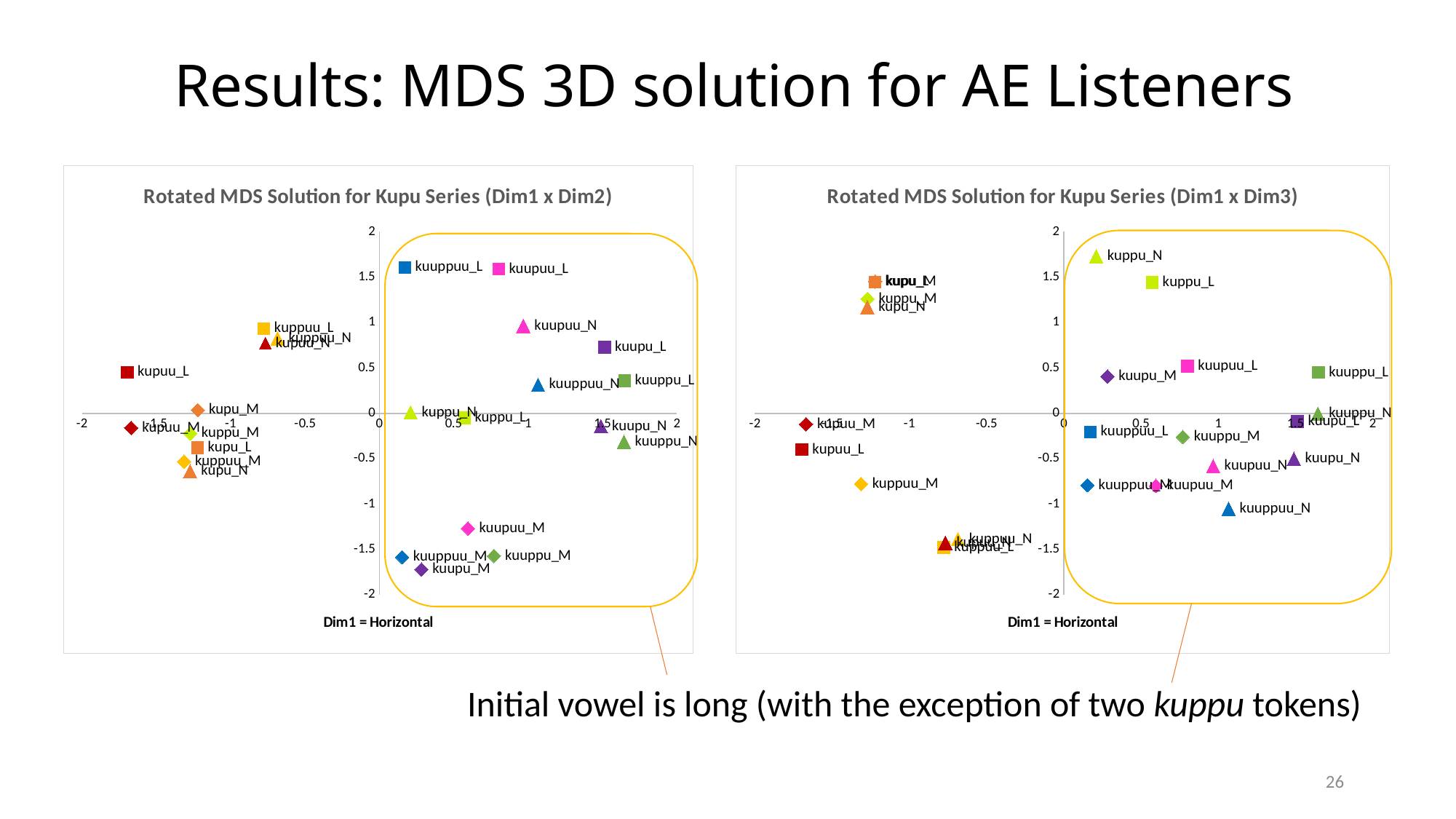
In the left chart (Dim1 x Dim2), is the horizontal value for kupuu_L greater or less than -1? less In the left chart (Dim1 x Dim2), which point is plotted higher on the vertical axis, kuuppuu_L or kuupuu_M? kuuppuu_L In the right chart (Dim1 x Dim3), is the vertical value for kuppu_N greater or less than 1.5? greater In the right chart (Dim1 x Dim3), is the vertical value for kuppuu_L greater or less than -1? less What kind of chart is the left chart, 'Rotated MDS Solution for Kupu Series (Dim1 x Dim2)'? Scatter chart In the left chart (Dim1 x Dim2), what text appears below the plot area describing the horizontal axis? Dim1 = Horizontal In the right chart (Dim1 x Dim3), which point is plotted further to the right, kuuppu_L or kupuu_L? kuuppu_L In the right chart (Dim1 x Dim3), which labelled point has the highest vertical value? kuppu_N What is the title of the right chart? Rotated MDS Solution for Kupu Series (Dim1 x Dim3)